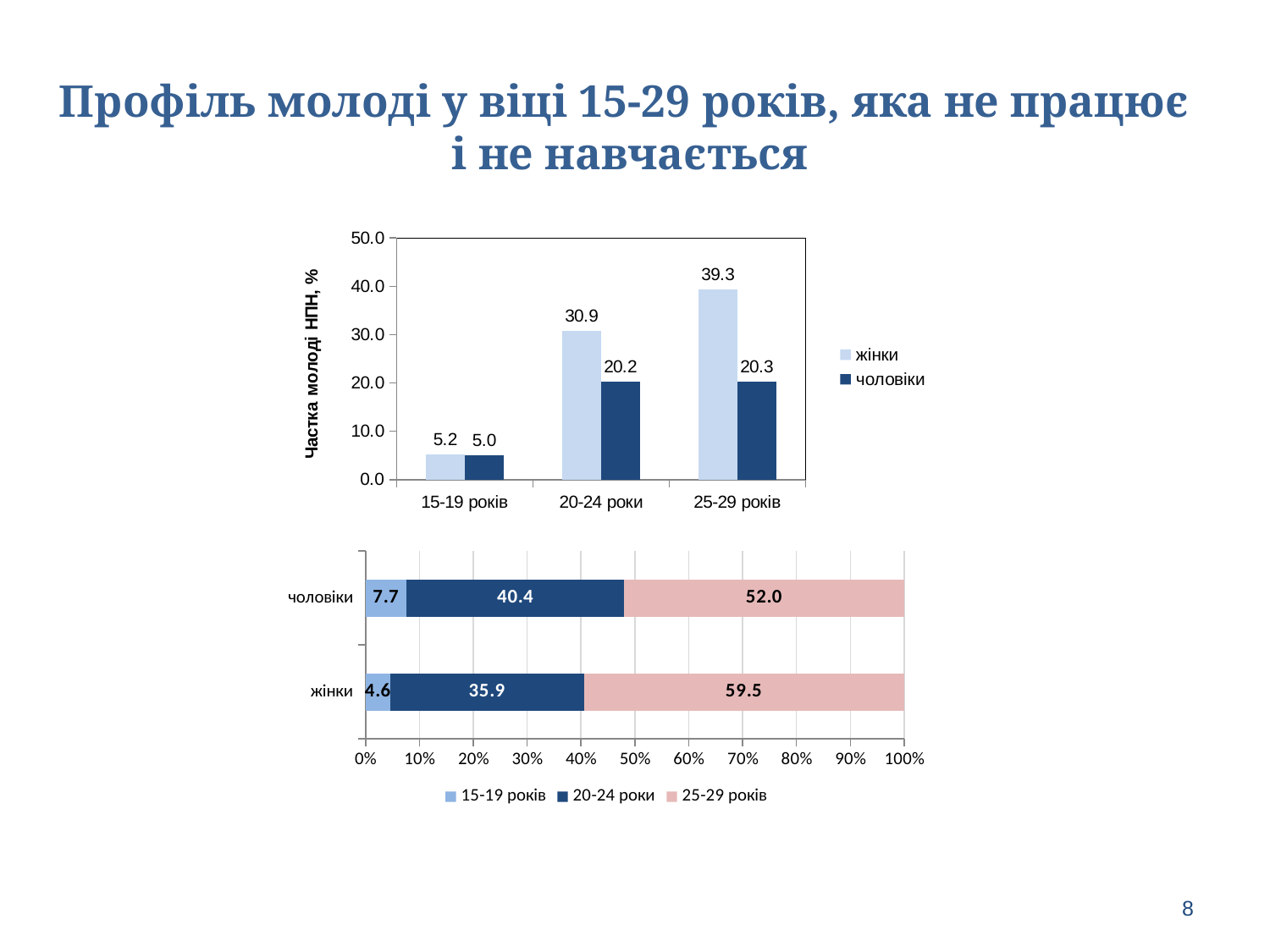
In the bottom chart, what is the difference between the 20-24 роки segments for чоловіки and жінки? 4.5 In the bottom chart, what is the value of the 25-29 років segment for жінки? 59.5 What type of chart is the bottom chart? stacked bar chart In the top chart, which age category has the highest value for жінки? 25-29 років In the top chart, do the values for жінки rise or fall from 15-19 років to 25-29 років? rise In the bottom chart, what is the value of the 15-19 років segment for чоловіки? 7.7 In the top chart, what is the value for жінки in the 25-29 років category? 39.3 In the top chart, which age category has the lowest value for чоловіки? 15-19 років In the top chart, what is the difference between жінки and чоловіки in the 20-24 роки category? 10.7 In the top chart, which is larger in the 25-29 років category: жінки or чоловіки? жінки In the top chart, how many series does the legend list? 2 In the top chart, what is the value for чоловіки in the 20-24 роки category? 20.2